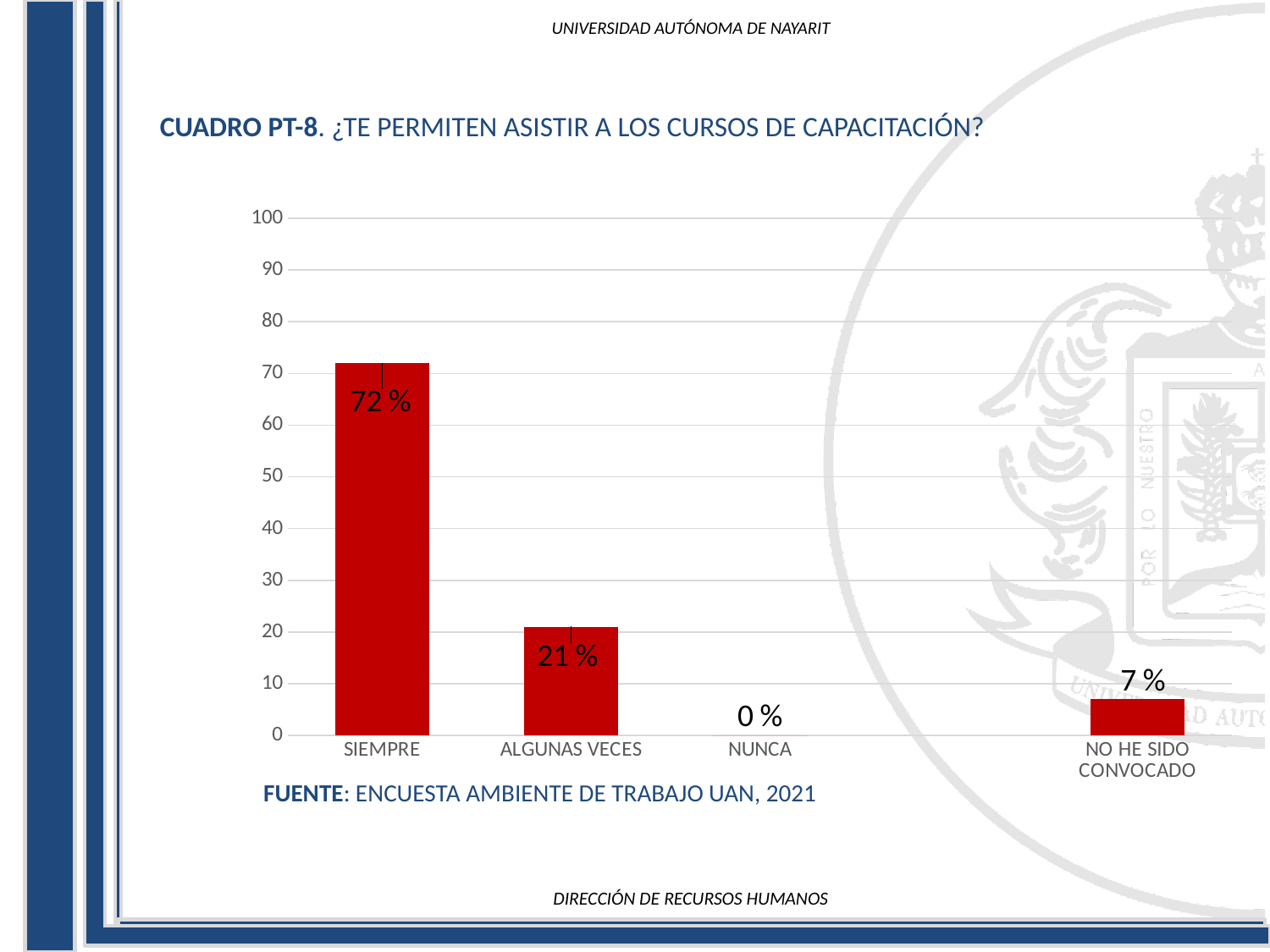
What is the value for ALGUNAS VECES? 21 % Which category has the highest value? SIEMPRE What kind of chart is shown on the slide? bar chart What is the value for NO HE SIDO CONVOCADO? 7 % What is the value for SIEMPRE? 72 % How many categories are shown on the x axis? 4 What is the source cited below the chart? ENCUESTA AMBIENTE DE TRABAJO UAN, 2021 What is the difference between the values for SIEMPRE and ALGUNAS VECES? 51 % Which category has the lowest value? NUNCA What is the value for NUNCA? 0 % Which is larger, the value for ALGUNAS VECES or the value for NO HE SIDO CONVOCADO? ALGUNAS VECES Is the value for SIEMPRE greater or less than 50? greater